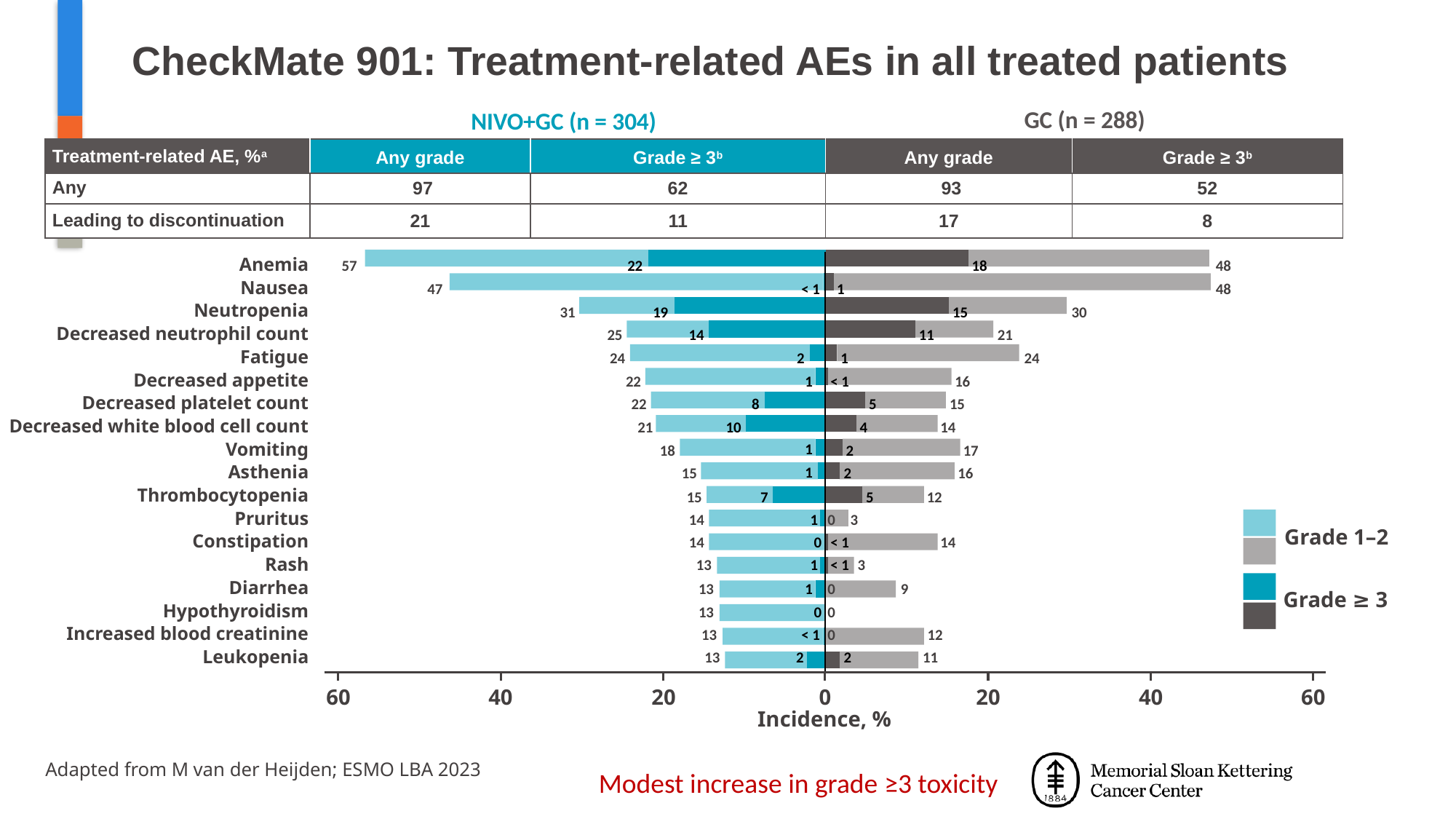
What is the grade ≥ 3 incidence of decreased white blood cell count in the NIVO+GC arm? 10 What is the any-grade incidence of nausea in the GC arm? 48 What kind of chart is used to show the treatment-related AE incidences? Bar chart Which treatment-related AE has the highest any-grade incidence in the NIVO+GC arm? Anemia What is the any-grade incidence of hypothyroidism in the GC arm? 0 What is the difference in any-grade neutropenia incidence between the NIVO+GC arm (31) and the GC arm (30)? 1 What is the any-grade incidence of anemia in the NIVO+GC arm? 57 What is the grade ≥ 3 incidence of anemia in the GC arm? 18 What is the label of the horizontal axis of the chart? Incidence, % Which treatment-related AE has the lowest any-grade incidence in the GC arm? Hypothyroidism How many treatment-related AEs are listed in the bar chart? 18 Which arm has the higher grade ≥ 3 incidence of neutropenia, NIVO+GC or GC? NIVO+GC